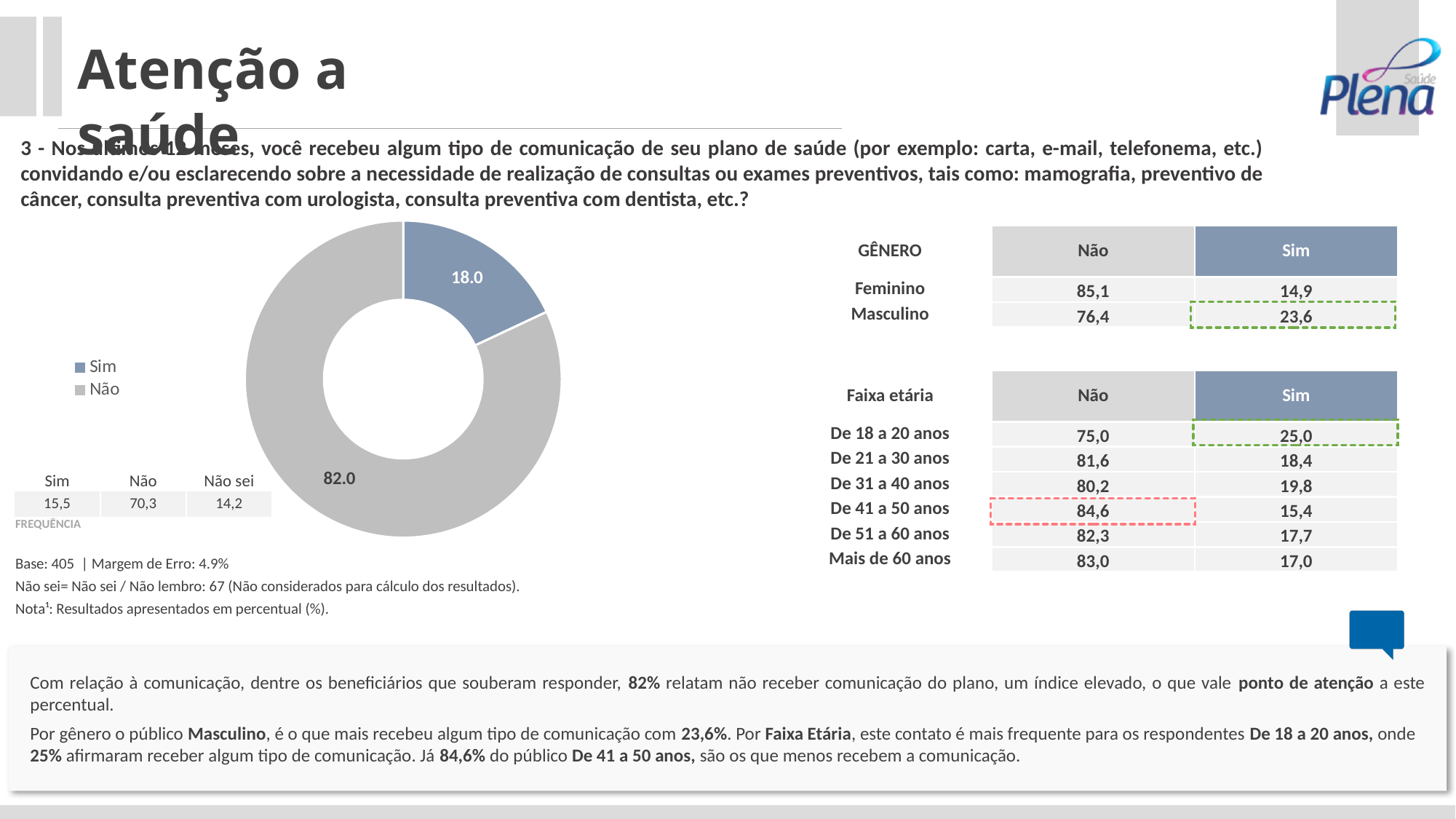
What are the two entries listed in the donut chart's legend? Sim, Não In the donut chart, what is the value shown for the Não slice? 82.0 What share of the donut chart does the Não slice represent? 82.0 How many slices does the donut chart have? 2 In the donut chart, what is the value shown for the Sim slice? 18.0 What kind of chart is shown on the left of the slide? Pie (donut) chart In the donut chart, what is the difference between the Não value and the Sim value? 64.0 Which slice of the donut chart is the largest? Não In the donut chart, which is larger, Sim or Não? Não What colour is the Sim slice in the donut chart? Blue What is the total of the two values shown in the donut chart? 100.0 Which slice of the donut chart is the smallest? Sim